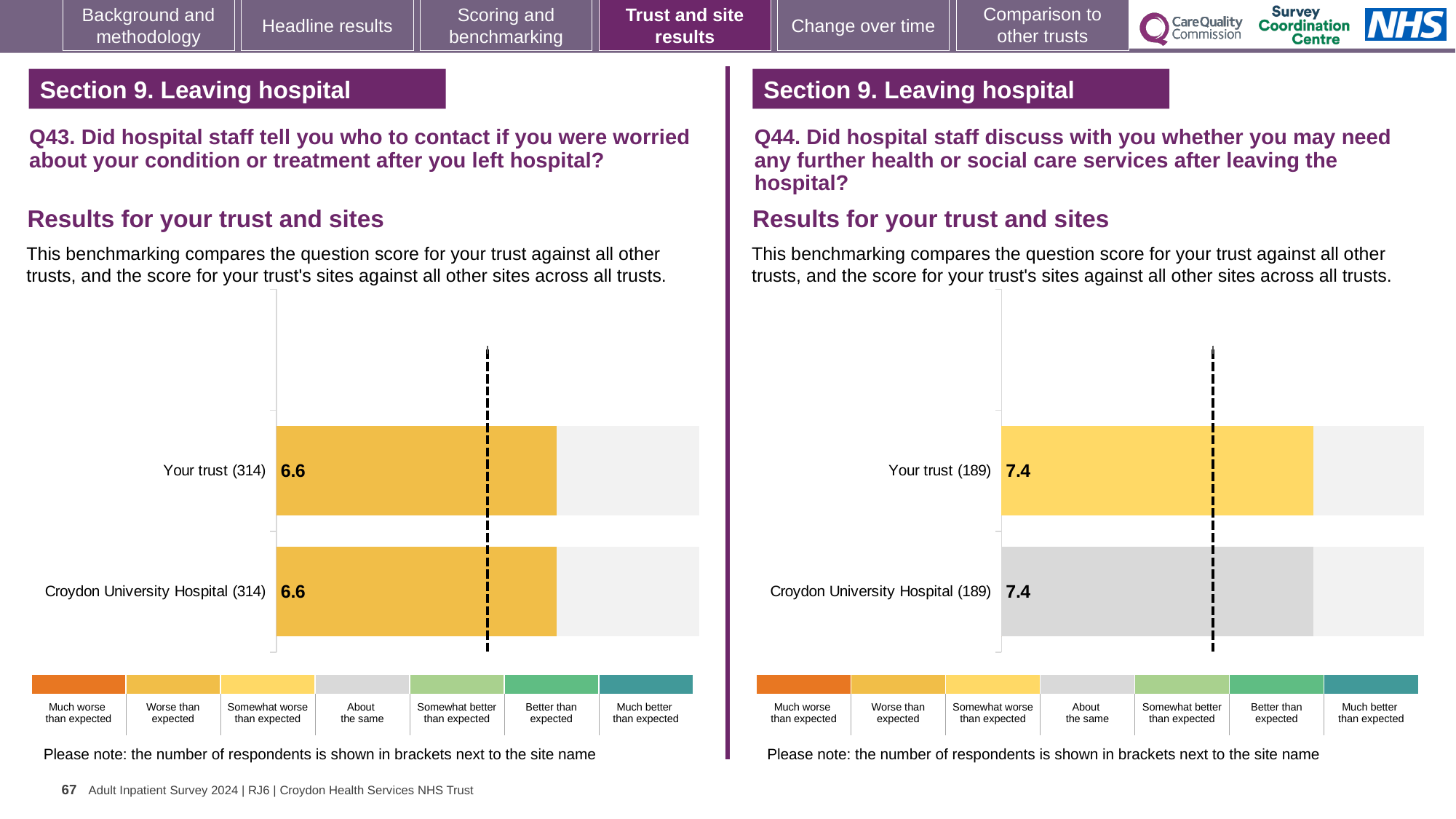
On the right chart (Q44), how many bars are plotted? 2 On the right chart (Q44), what is the score for Croydon University Hospital? 7.4 On the right chart (Q44), what is the score for Your trust? 7.4 On the left chart (Q43), which benchmark category does the colour of the Your trust bar correspond to? Worse than expected On the left chart (Q43), what is the difference between the score for Your trust and the score for Croydon University Hospital? 0 On the right chart (Q44), which benchmark category does the colour of the Croydon University Hospital bar correspond to? About the same On the left chart (Q43), how many respondents are shown in brackets for Your trust? 314 On the left chart (Q43), what is the score for Your trust? 6.6 On the right chart (Q44), how many respondents are shown in brackets for Croydon University Hospital? 189 What kind of chart is shown on the left (Q43)? Bar chart On the left chart (Q43), what is the score for Croydon University Hospital? 6.6